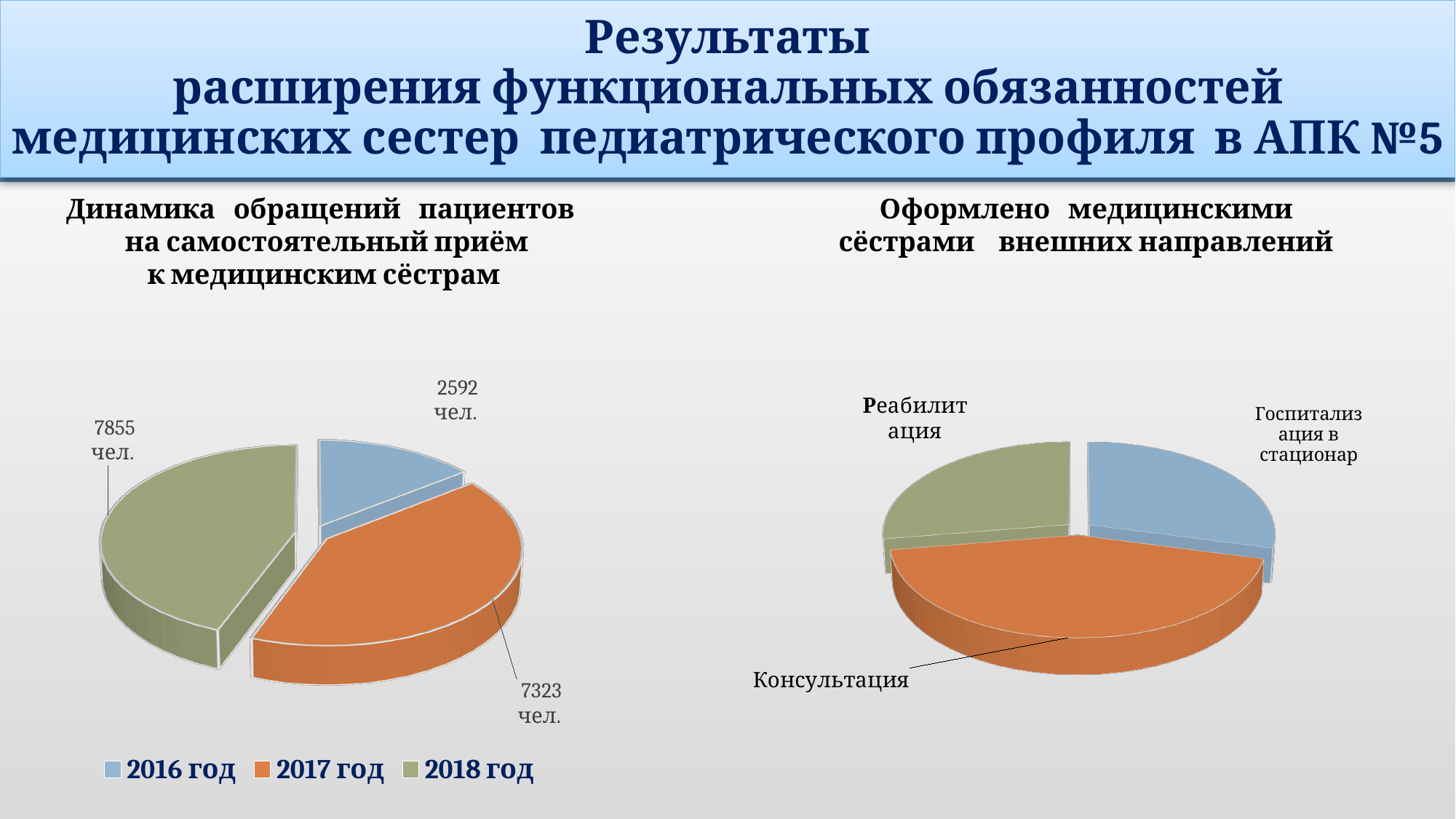
On the right chart (Оформлено медицинскими сёстрами внешних направлений), which slice is the largest? Консультация On the left chart (Динамика обращений пациентов), what is the value for 2017 год? 7323 чел. How many entries does the legend of the left chart (Динамика обращений пациентов) list? 3 On the left chart (Динамика обращений пациентов), which year has the highest value? 2018 год On the left chart (Динамика обращений пациентов), what is the difference between the values for 2018 год and 2017 год? 532 чел. What kind of chart is the right chart (Оформлено медицинскими сёстрами внешних направлений)? Pie chart How many slices does the right chart (Оформлено медицинскими сёстрами внешних направлений) have? 3 On the left chart (Динамика обращений пациентов), what is the total of all three slices? 17770 чел. On the left chart (Динамика обращений пациентов), which year has the lowest value? 2016 год On the left chart (Динамика обращений пациентов), what is the value for 2018 год? 7855 чел. On the left chart (Динамика обращений пациентов), what is the value for 2016 год? 2592 чел. On the left chart (Динамика обращений пациентов), which is larger: the value for 2017 год or 2016 год? 2017 год